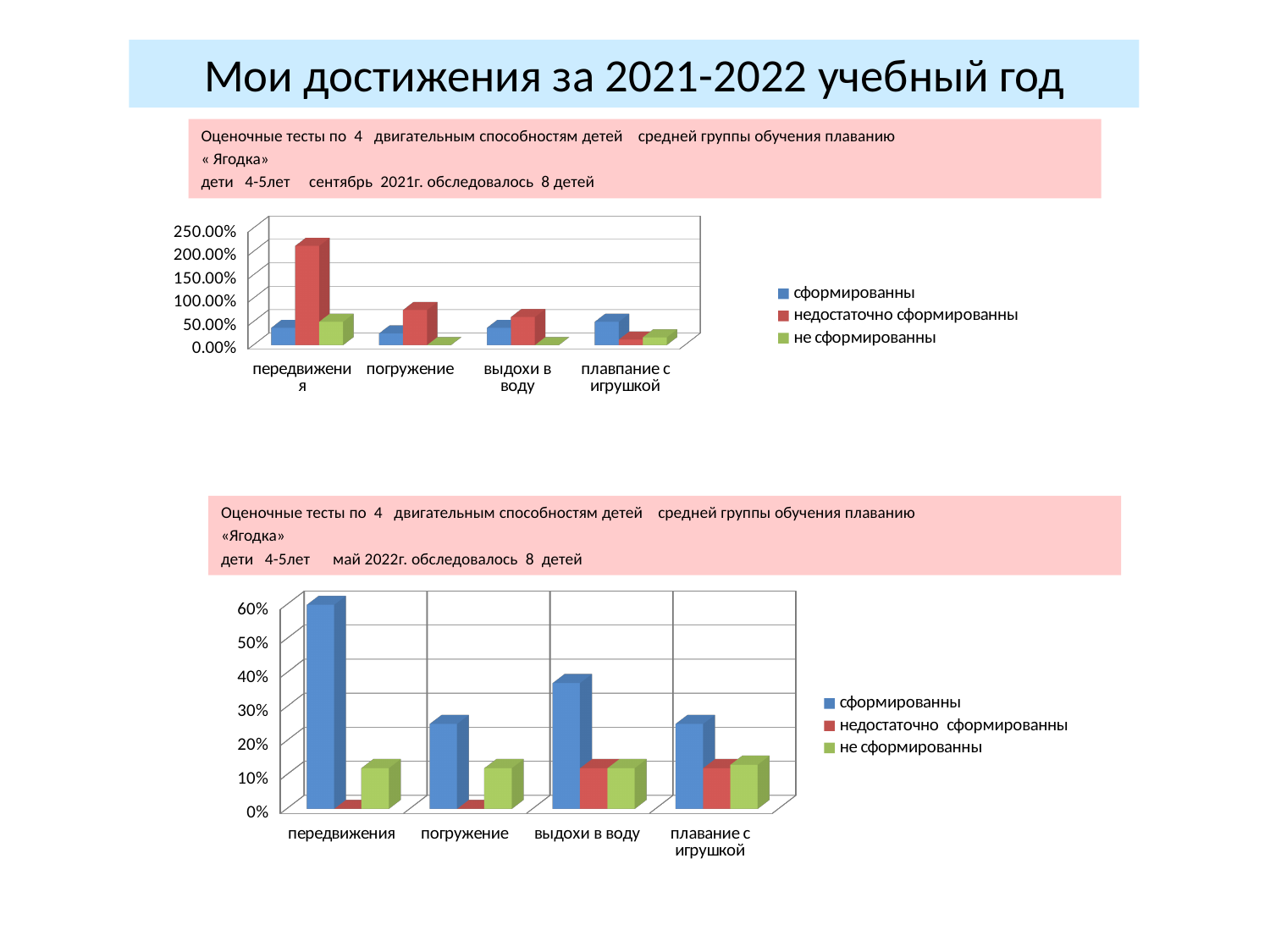
In the bottom chart (май 2022г.), is the value for сформированны in погружение greater or less than 30%? less In the top chart (сентябрь 2021г.), is the value for недостаточно сформированны in погружение greater or less than 100.00%? less In the top chart (сентябрь 2021г.), for плавание с игрушкой, which is larger: сформированны or недостаточно сформированны? сформированны How many categories are shown on the x axis of the bottom chart (май 2022г.)? 4 What colour represents the series не сформированны in the bottom chart's legend? green In the top chart (сентябрь 2021г.), is the value for недостаточно сформированны in передвижения greater or less than 150.00%? greater What kind of chart is the bottom chart (май 2022г.)? bar chart In the top chart (сентябрь 2021г.), which category has the highest bar for недостаточно сформированны? передвижения In the bottom chart (май 2022г.), which has the larger сформированны value: выдохи в воду or погружение? выдохи в воду In the bottom chart (май 2022г.), which category has the highest bar for сформированны? передвижения How many series does the legend of the top chart (сентябрь 2021г.) list? 3